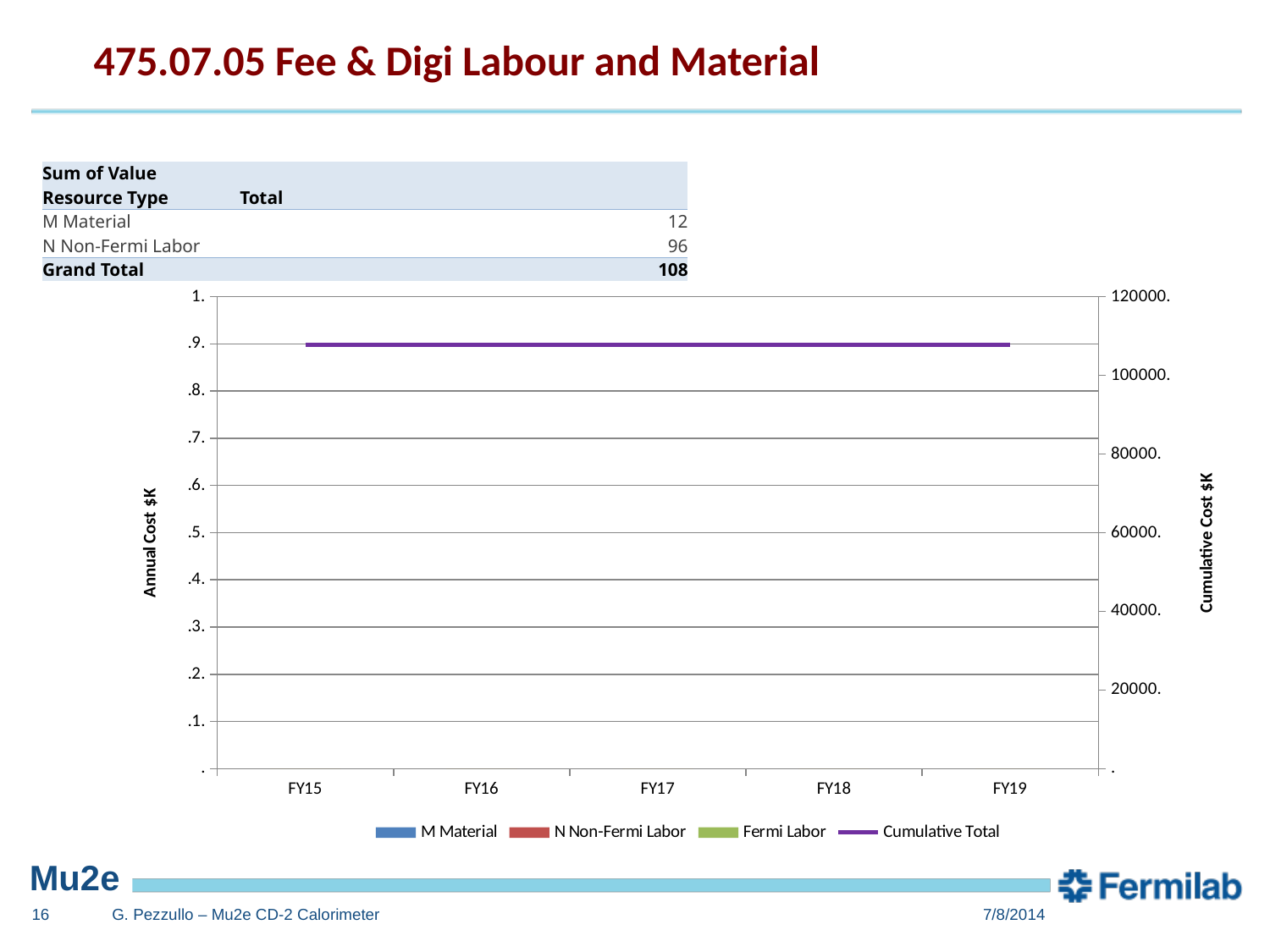
Is the Cumulative Total value at FY15 greater or less than 100000 on the right axis? greater What is the first fiscal year shown on the x axis of the chart? FY15 Does the Cumulative Total line rise, fall, or stay flat from FY15 to FY19? stays flat What is the title of the right-hand vertical axis of the chart? Cumulative Cost $K Is the Cumulative Total value at FY19 greater or less than 120000 on the right axis? less Which series is drawn as a line in the chart? Cumulative Total How many series does the chart legend list? 4 How many fiscal years are shown on the x axis of the chart? 5 What is the last fiscal year shown on the x axis of the chart? FY19